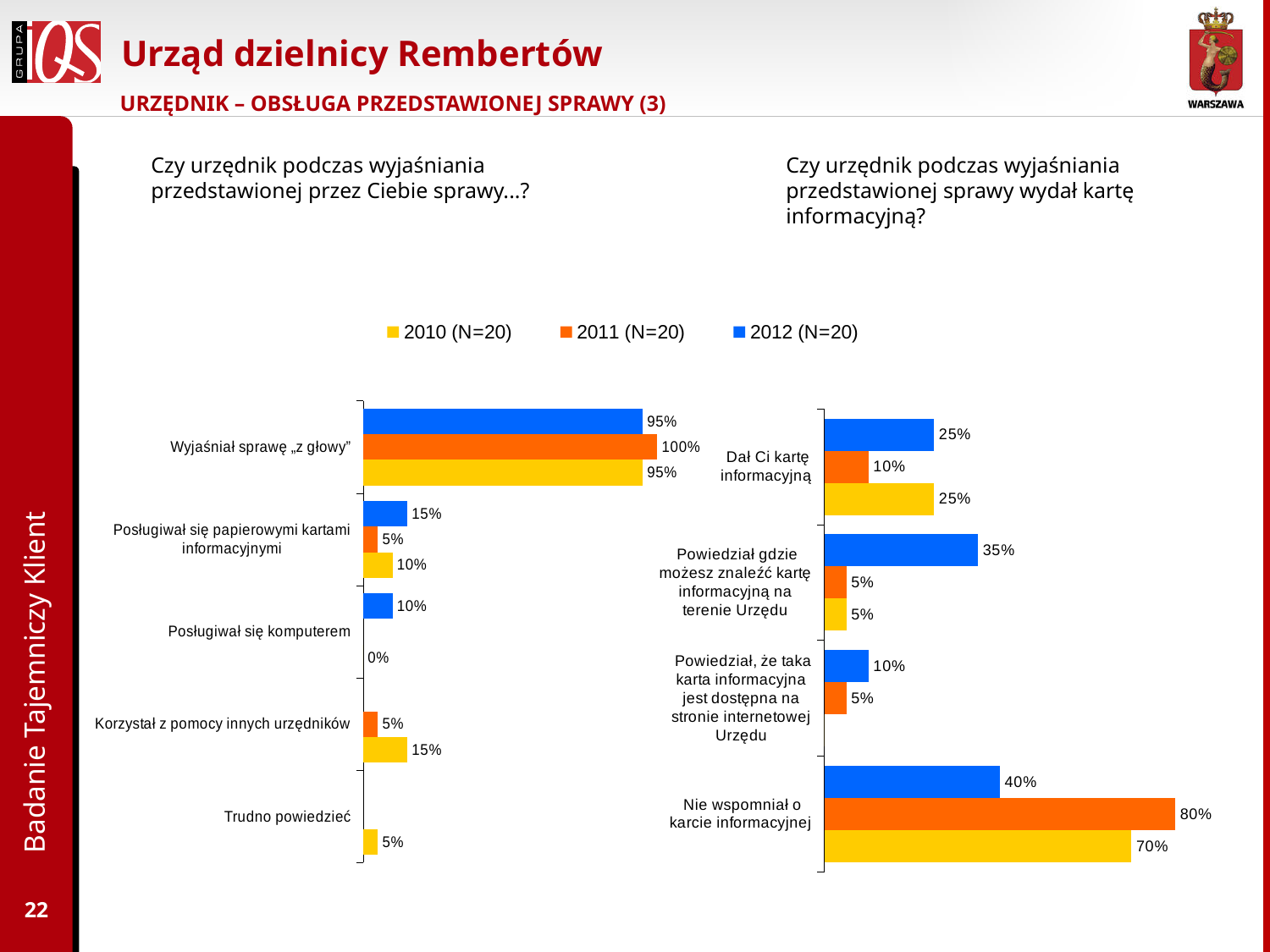
In the left chart, which is larger for "Posługiwał się papierowymi kartami informacyjnymi": the 2012 (N=20) value or the 2010 (N=20) value? 2012 (N=20) In the right chart, which category has the highest value for 2012 (N=20)? Nie wspomniał o karcie informacyjnej In the left chart, what is the value for "Posługiwał się papierowymi kartami informacyjnymi" in 2012 (N=20)? 15% In the right chart ("Czy urzędnik podczas wyjaśniania przedstawionej sprawy wydał kartę informacyjną?"), what is the value for "Nie wspomniał o karcie informacyjnej" in 2011 (N=20)? 80% What kind of chart is the left chart? Bar chart In the left chart, what is the value for "Korzystał z pomocy innych urzędników" in 2010 (N=20)? 15% How many series does the legend list? 3 In the right chart, what is the difference between the 2011 (N=20) and 2010 (N=20) values for "Nie wspomniał o karcie informacyjnej"? 10% In the left chart ("Czy urzędnik podczas wyjaśniania przedstawionej przez Ciebie sprawy...?"), what is the value for "Wyjaśniał sprawę „z głowy”" in 2011 (N=20)? 100% In the right chart, what is the value for "Powiedział gdzie możesz znaleźć kartę informacyjną na terenie Urzędu" in 2012 (N=20)? 35% In the left chart, what is the value for "Trudno powiedzieć" in 2010 (N=20)? 5% In the right chart, what is the difference between the 2012 (N=20) and 2011 (N=20) values for "Dał Ci kartę informacyjną"? 15%